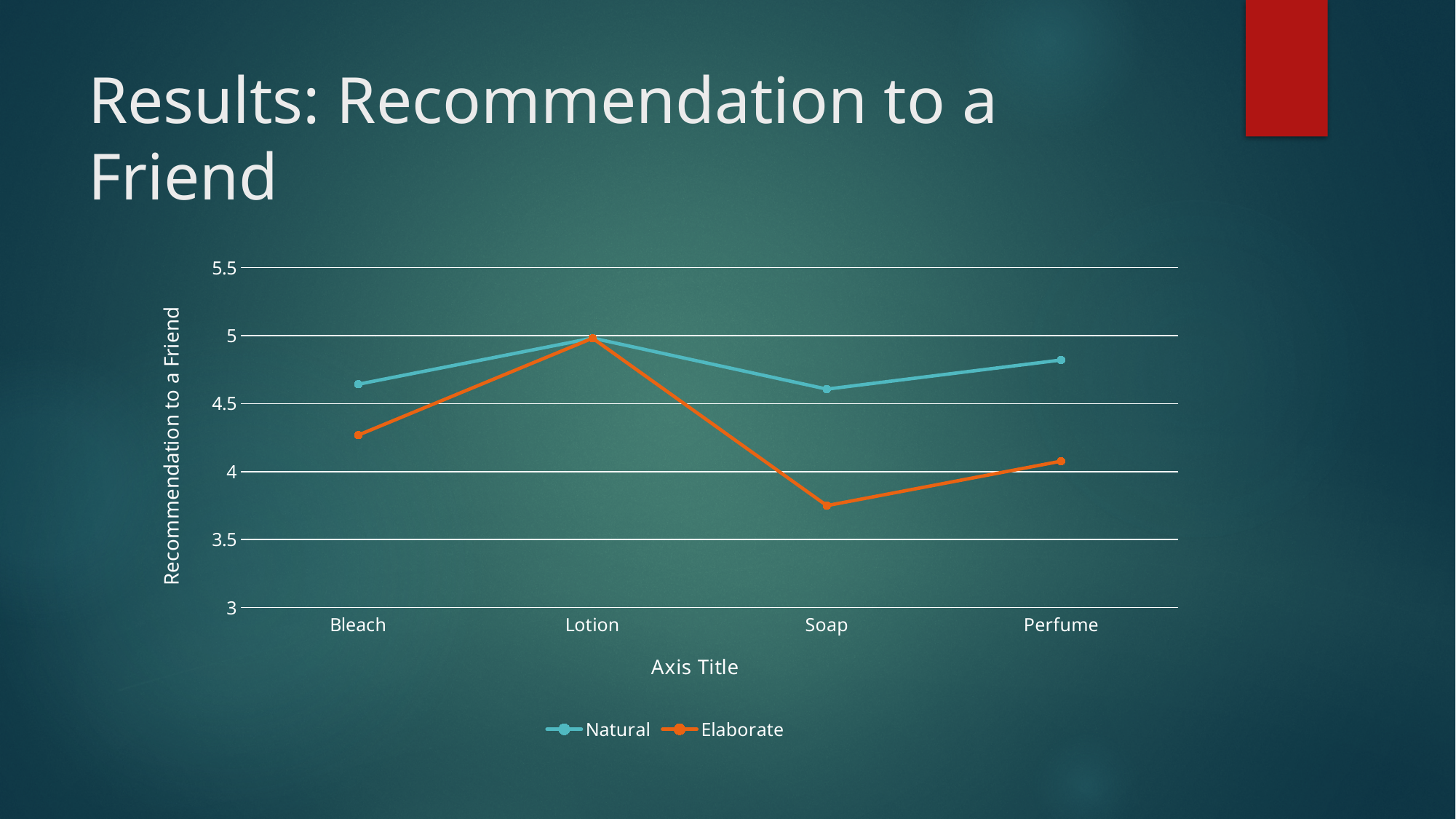
How many categories are shown on the x axis? 4 Is the Natural value for Perfume greater or less than 4.5? greater How many series does the legend list? 2 At Soap, which series has the larger value, Natural or Elaborate? Natural For the Elaborate series, which category has the highest value? Lotion Is the Elaborate value for Bleach greater or less than 4.5? less What kind of chart is shown on the slide? line chart Does the Elaborate series rise or fall from Soap to Perfume? rise Is the Elaborate value for Soap greater or less than 4? less For the Elaborate series, which category has the lowest value? Soap What is the title of the vertical axis? Recommendation to a Friend For the Natural series, which category has the highest value? Lotion